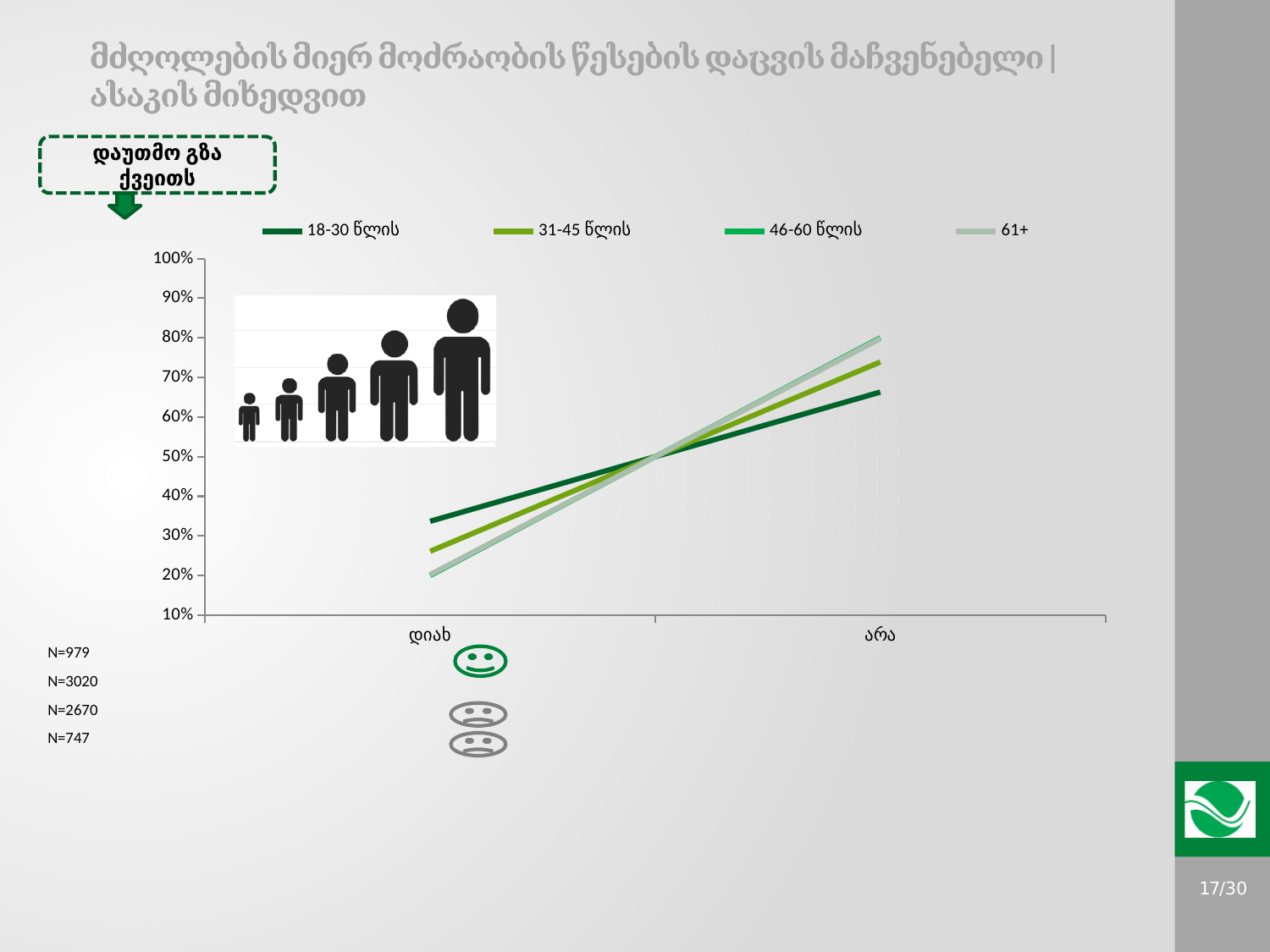
Is the value for 18-30 წლის at დიახ greater or less than 40%? less Which age group is listed last in the chart legend? 61+ Is the value for 61+ at დიახ greater or less than 30%? less Does the 61+ line rise or fall from დიახ to არა? rise At დიახ, which is higher: the 18-30 წლის line or the 61+ line? 18-30 წლის How many series does the chart legend list? 4 How many categories are on the x axis of the chart? 2 Is the value for 61+ at არა greater or less than 70%? greater What are the two categories on the x axis of the chart? დიახ and არა At არა, which is higher: the 18-30 წლის line or the 61+ line? 61+ Does the 18-30 წლის line rise or fall from დიახ to არა? rise What kind of chart is shown on the slide? line chart